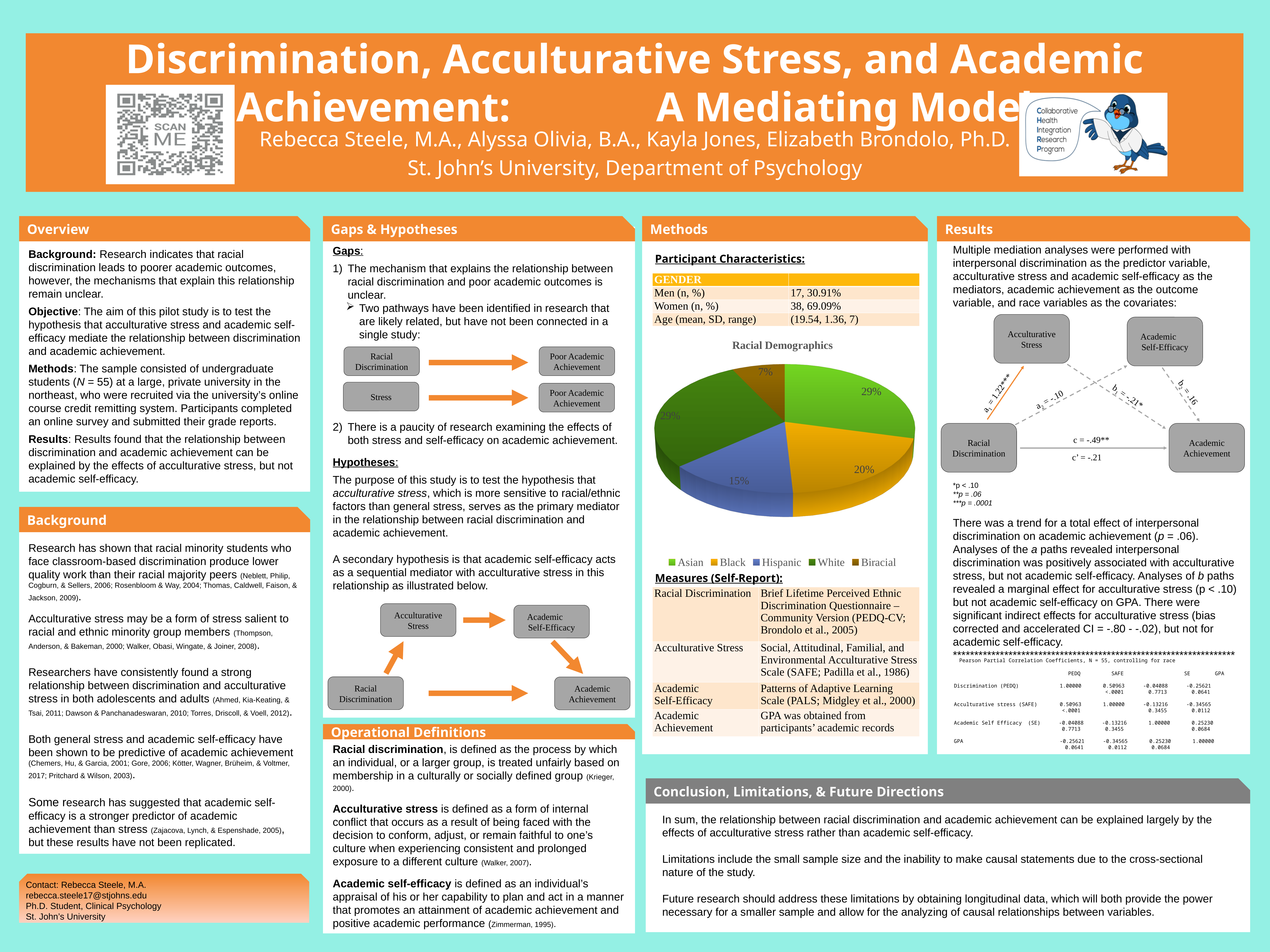
What kind of chart is the Racial Demographics chart? pie chart What percentage of the Racial Demographics pie is Black? 20% What is the title of the pie chart in the Methods section? Racial Demographics Which colour represents Hispanic in the Racial Demographics pie chart legend? blue How many categories does the Racial Demographics pie chart show? 5 In the Racial Demographics pie chart, what is the combined share of the Asian and White slices? 58% What percentage of the Racial Demographics pie is Hispanic? 15% What percentage of the Racial Demographics pie is Asian? 29% In the Racial Demographics pie chart, what is the difference between the Black and Hispanic percentages? 5% What percentage of the Racial Demographics pie is Biracial? 7% Which category has the smallest slice in the Racial Demographics pie chart? Biracial In the Racial Demographics pie chart, which is larger, the Black slice or the Hispanic slice? Black